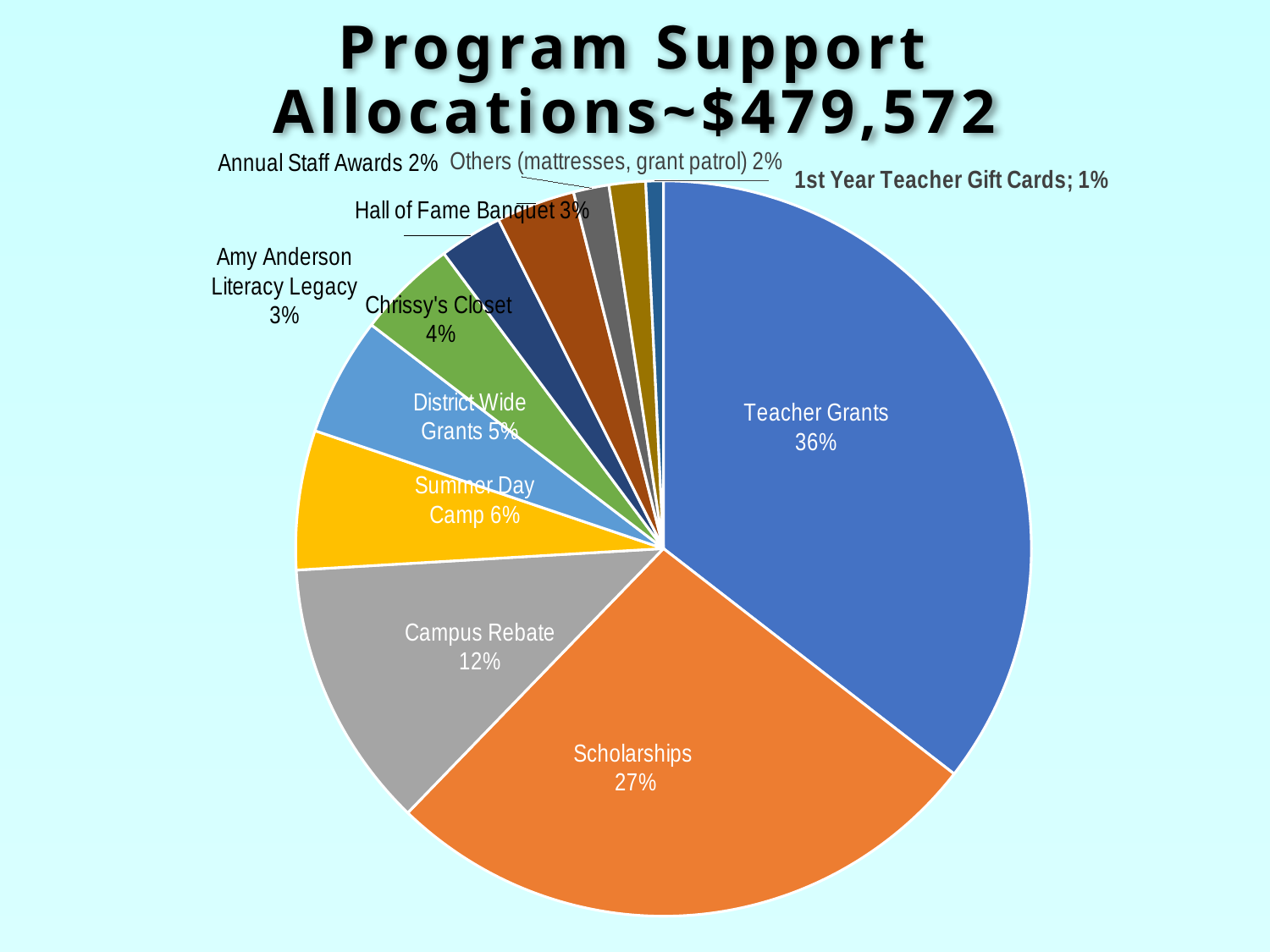
What is the difference in percentage points between Teacher Grants and Scholarships? 9 percentage points What kind of chart is shown on the slide? Pie chart What percentage is shown for Summer Day Camp? 6% What percentage is shown for Campus Rebate? 12% What share of the pie is Scholarships? 27% Which category has the smallest slice of the pie? 1st Year Teacher Gift Cards What percentage is shown for Chrissy's Closet? 4% What percentage is shown for 1st Year Teacher Gift Cards? 1% How many slices does the pie chart have? 11 What share of the pie is Teacher Grants? 36% Which category has the largest slice of the pie? Teacher Grants What is the title of the chart? Program Support Allocations~$479,572